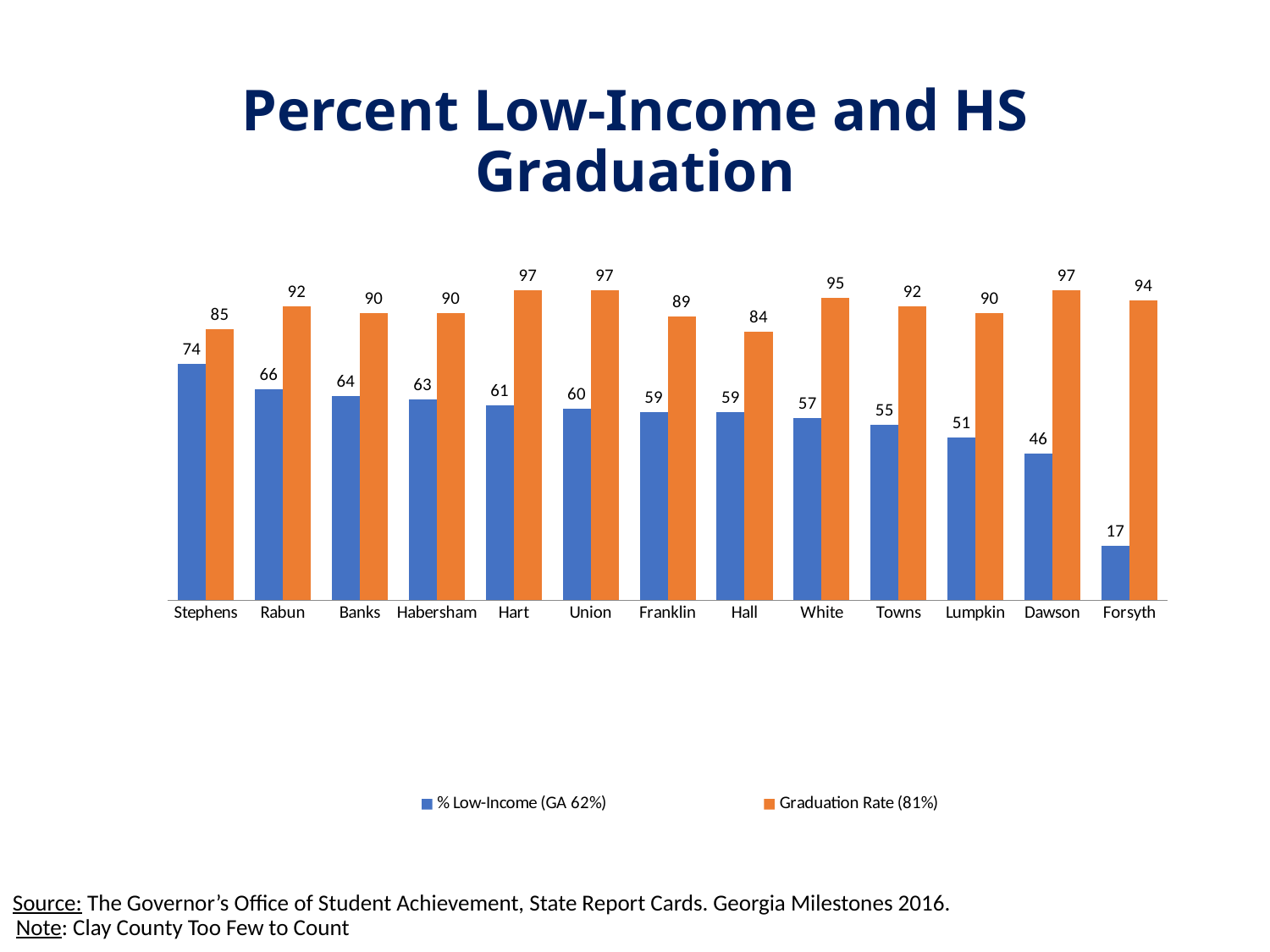
What is the title of the chart? Percent Low-Income and HS Graduation What kind of chart is shown on the slide? Bar chart Which county has the lowest Graduation Rate? Hall Which county has the highest % Low-Income value? Stephens How many series does the legend list? 2 Which is larger, the Graduation Rate for Rabun or the Graduation Rate for Franklin? Rabun Which county has the lowest % Low-Income value? Forsyth What is the Graduation Rate for Forsyth? 94 How many counties are shown on the x axis? 13 What is the Graduation Rate for Hall? 84 What is the % Low-Income value for Stephens? 74 What is the difference between the Graduation Rate and the % Low-Income value for Dawson? 51